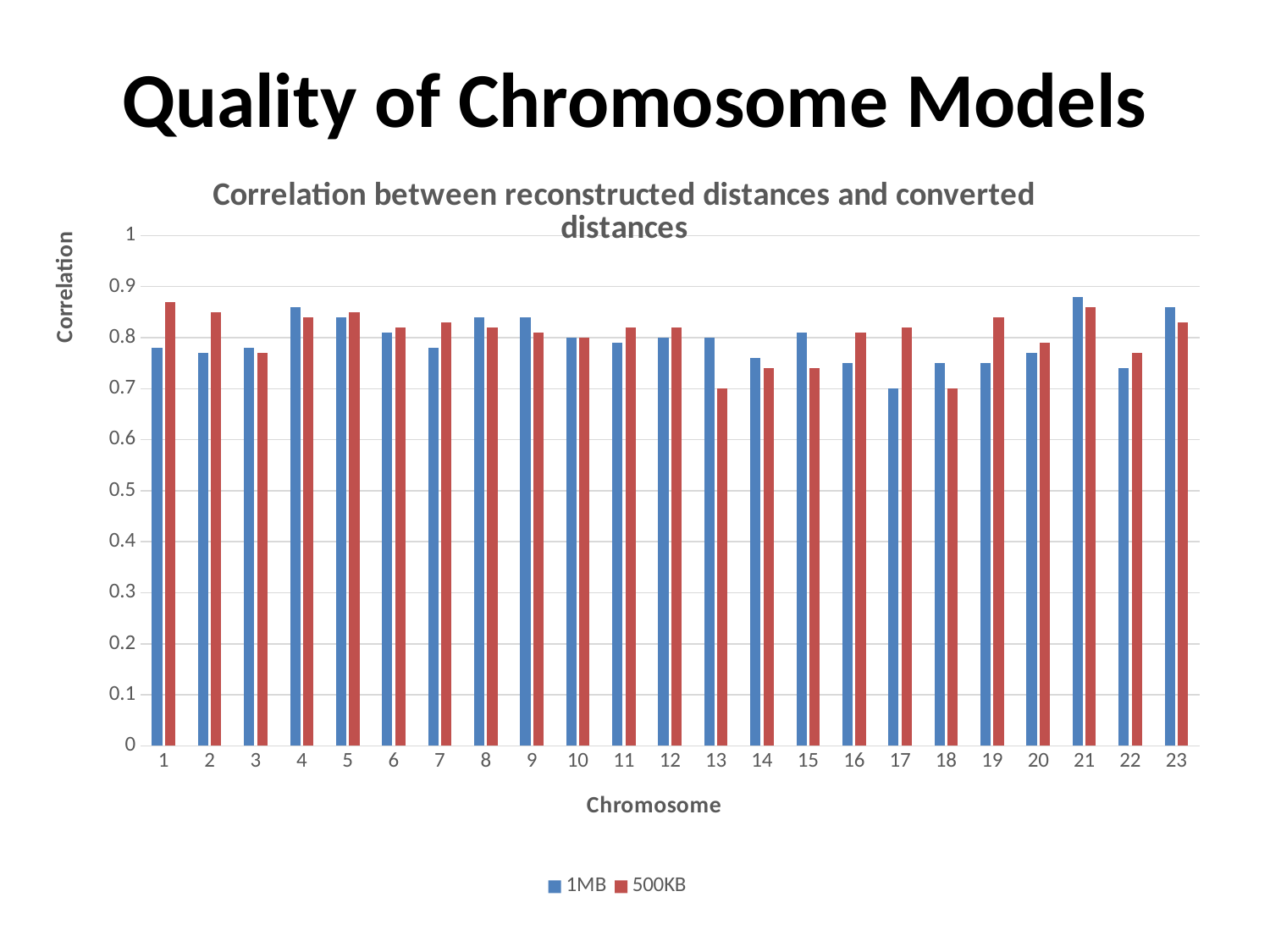
What is the title of the chart? Correlation between reconstructed distances and converted distances How many series does the chart's legend list? 2 For which chromosome is the 1MB correlation lowest? 17 For chromosome 13, which series has the higher correlation, 1MB or 500KB? 1MB Is the 1MB correlation for chromosome 14 greater or less than 0.8? less For which chromosome is the 1MB correlation highest? 21 For chromosome 1, which series has the higher correlation, 1MB or 500KB? 500KB What kind of chart is shown on the slide? bar chart Is the 1MB correlation for chromosome 22 greater or less than 0.8? less Which series is drawn in red in the chart? 500KB How many chromosomes are shown along the x axis of the chart? 23 Is the 500KB correlation for chromosome 19 greater or less than 0.8? greater